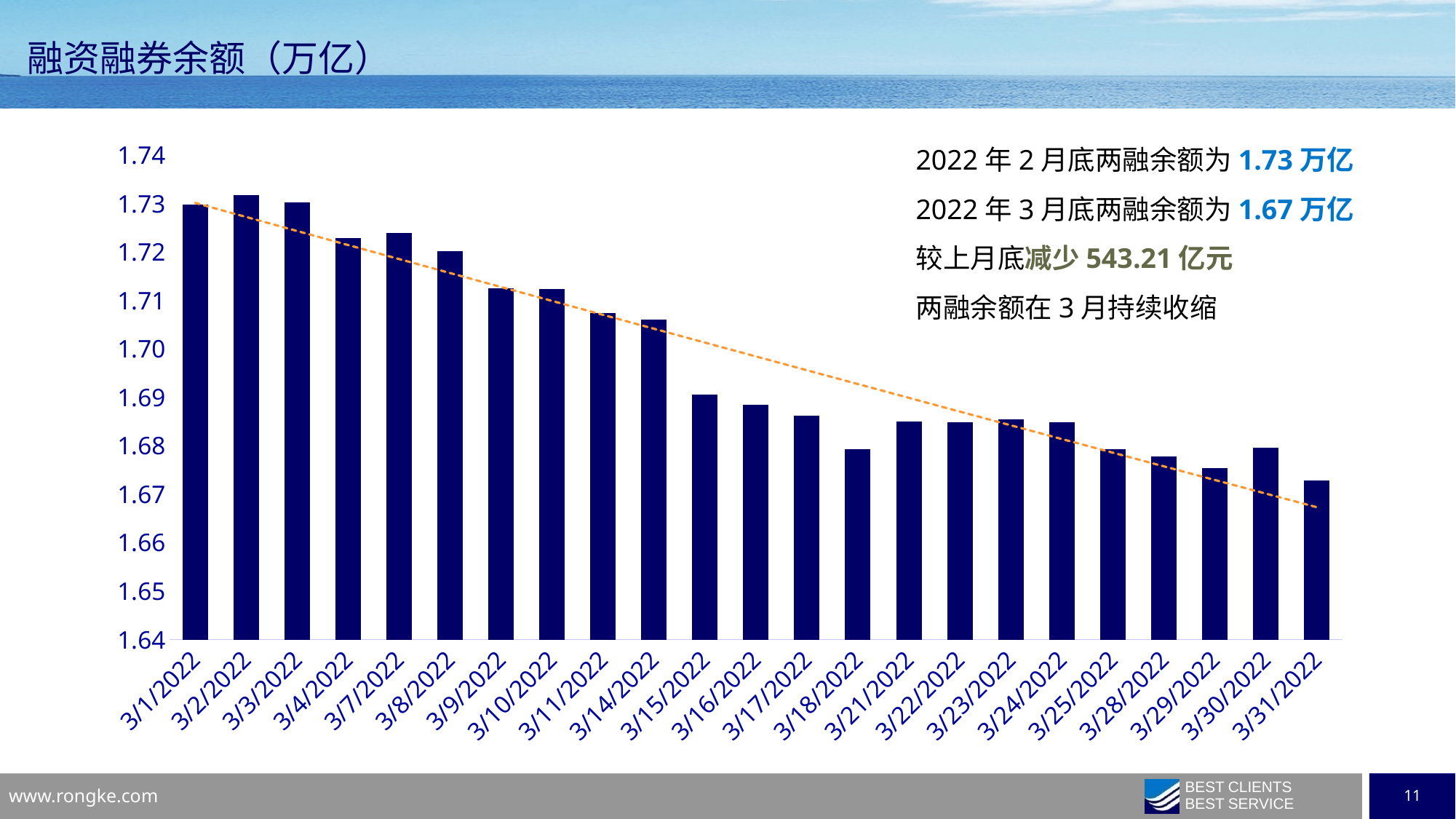
Which is larger, the value for 3/10/2022 or the value for 3/15/2022? 3/10/2022 Which date has the highest bar? 3/2/2022 Is the value for 3/7/2022 greater or less than 1.72? greater Which date has the lowest bar? 3/31/2022 What does the dashed orange line on the chart represent? a trend line Do the values generally rise or fall from 3/1/2022 to 3/31/2022? fall What is the title of the chart? 融资融券余额（万亿） Is the value for 3/17/2022 greater or less than 1.69? less Is the value for 3/14/2022 greater or less than 1.70? greater How many dates (bars) are plotted on the x axis? 23 What kind of chart is shown on the slide? bar chart